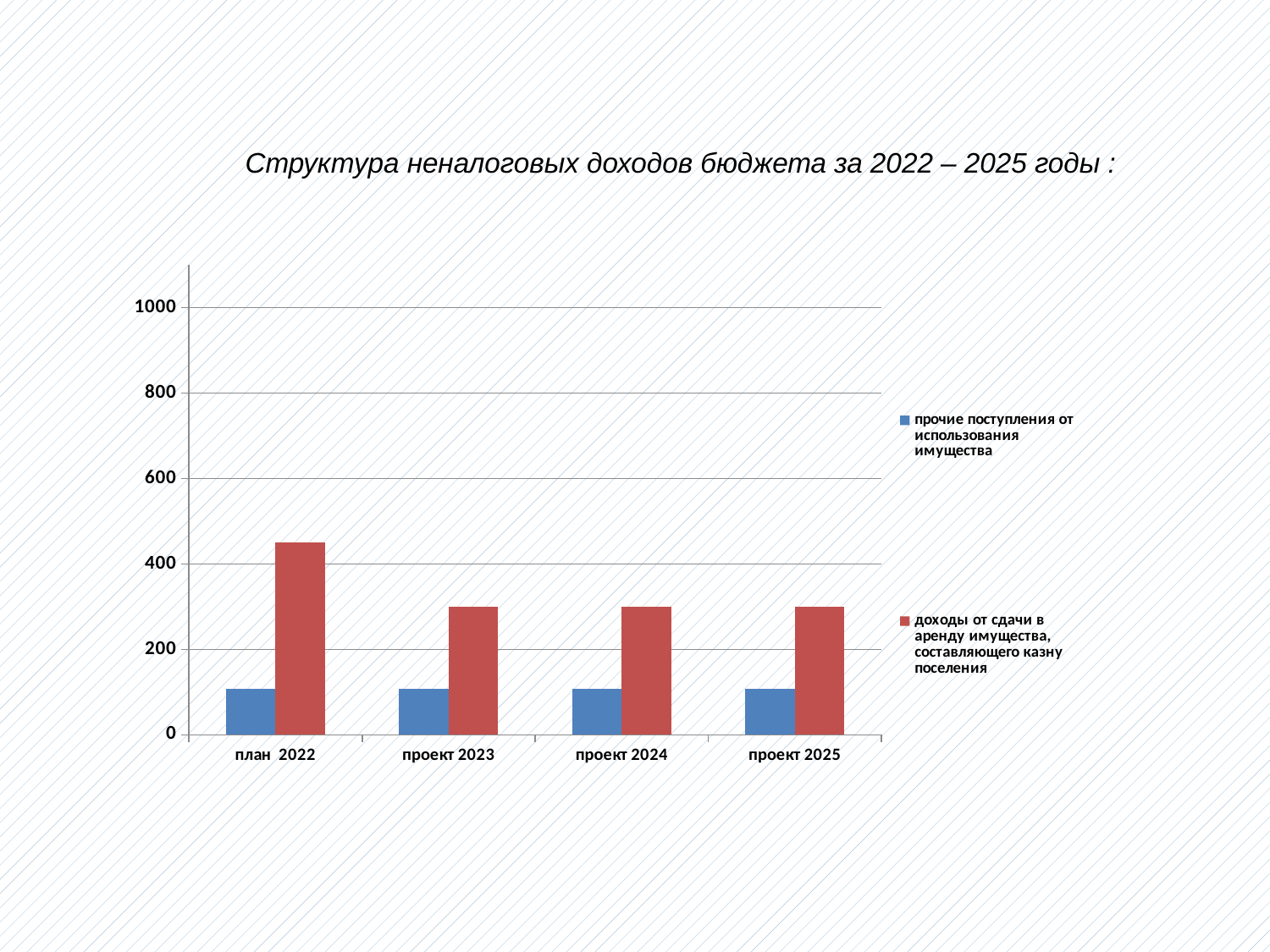
Does the value for 'доходы от сдачи в аренду имущества, составляющего казну поселения' rise or fall from план 2022 to проект 2023? fall What kind of chart is shown on the slide? bar chart Is the value for 'прочие поступления от использования имущества' in проект 2024 greater or less than 200? less Is the value for 'доходы от сдачи в аренду имущества, составляющего казну поселения' in проект 2025 greater or less than 200? greater Is the value for 'доходы от сдачи в аренду имущества, составляющего казну поселения' in план 2022 greater or less than 400? greater What colour are the bars for the series 'прочие поступления от использования имущества'? blue How many categories are shown on the x axis of the chart? 4 What is the title of the slide above the chart? Структура неналоговых доходов бюджета за 2022 – 2025 годы In план 2022, which series has the larger value: 'прочие поступления от использования имущества' or 'доходы от сдачи в аренду имущества, составляющего казну поселения'? доходы от сдачи в аренду имущества, составляющего казну поселения How many series does the chart's legend list? 2 Which category has the highest value for the series 'доходы от сдачи в аренду имущества, составляющего казну поселения'? план 2022